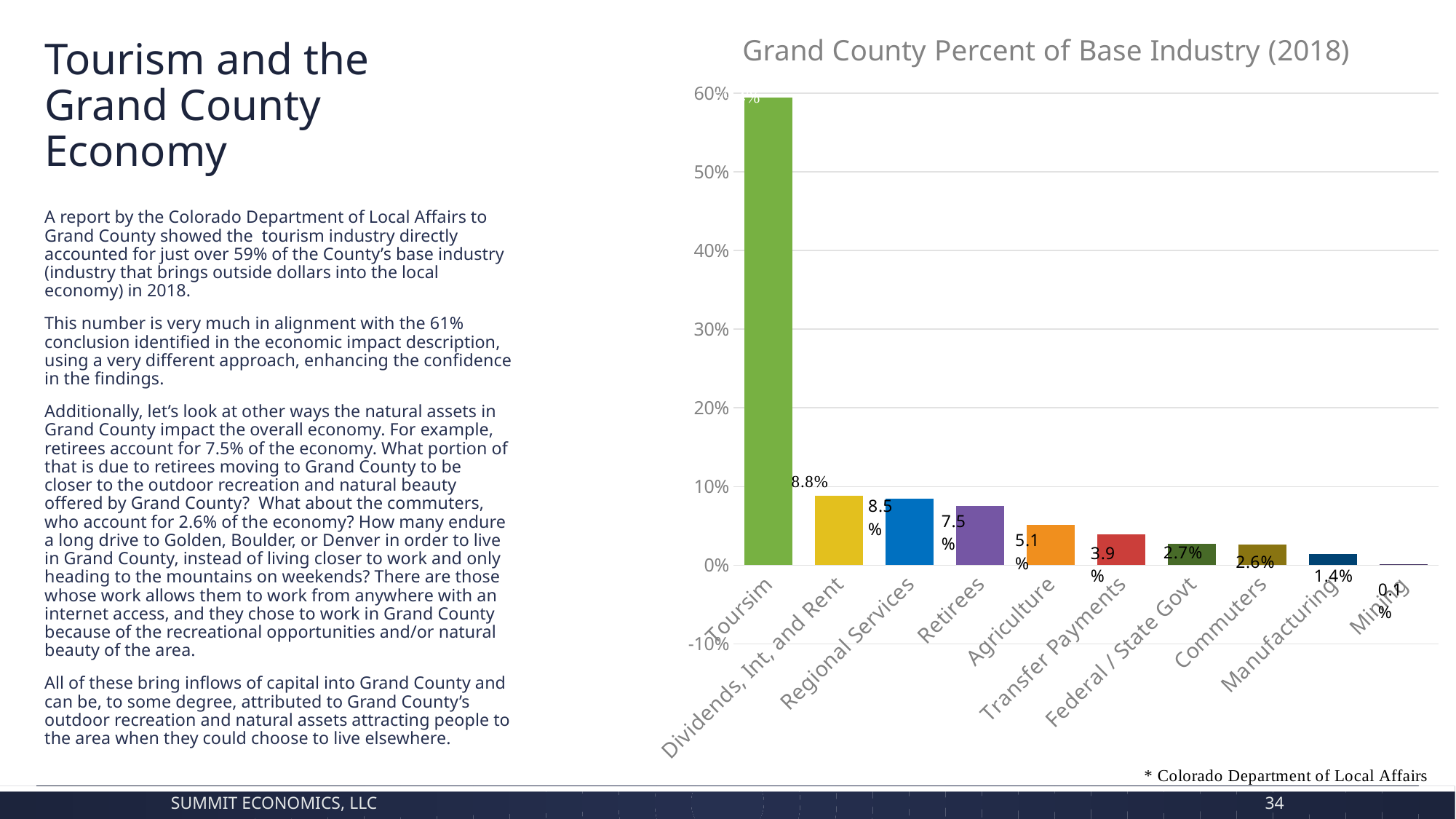
How many categories are plotted in the chart? 10 What is the difference between the values for Retirees and Agriculture? 2.4% Which category has the highest value? Toursim Which category has the lowest value? Mining Is the value for Toursim greater or less than 50%? greater What type of chart is shown on the slide? Bar chart What is the value for Dividends, Int, and Rent? 8.8% Do the values rise or fall moving from left to right along the x axis? Fall What is the value for Mining? 0.1% What is the value for Retirees? 7.5% What is the value for Commuters? 2.6% What is the title of the chart? Grand County Percent of Base Industry (2018)